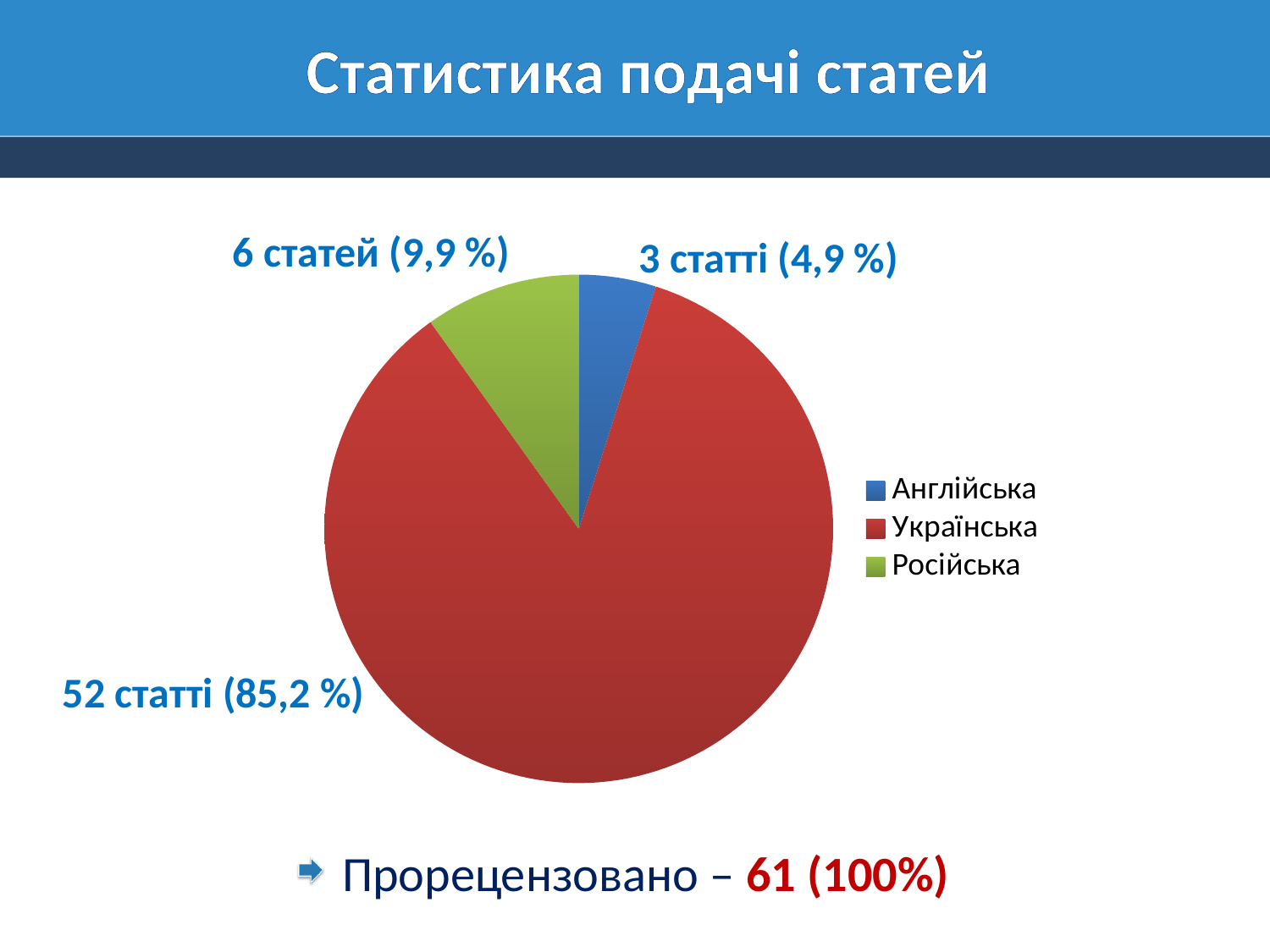
What is the title of the slide containing the pie chart? Статистика подачі статей What share of the pie does the Українська slice take? 85,2 % What kind of chart is shown on the slide? pie chart How many articles does the Англійська slice represent? 3 статті How many articles does the Українська slice represent? 52 статті How many articles does the Російська slice represent? 6 статей What share of the pie does the Англійська slice take? 4,9 % Which colour represents Українська in the pie chart? red Which category has the smallest slice in the pie chart? Англійська Which category has the largest slice in the pie chart? Українська How many entries does the legend of the pie chart list? 3 How many slices does the pie chart have? 3